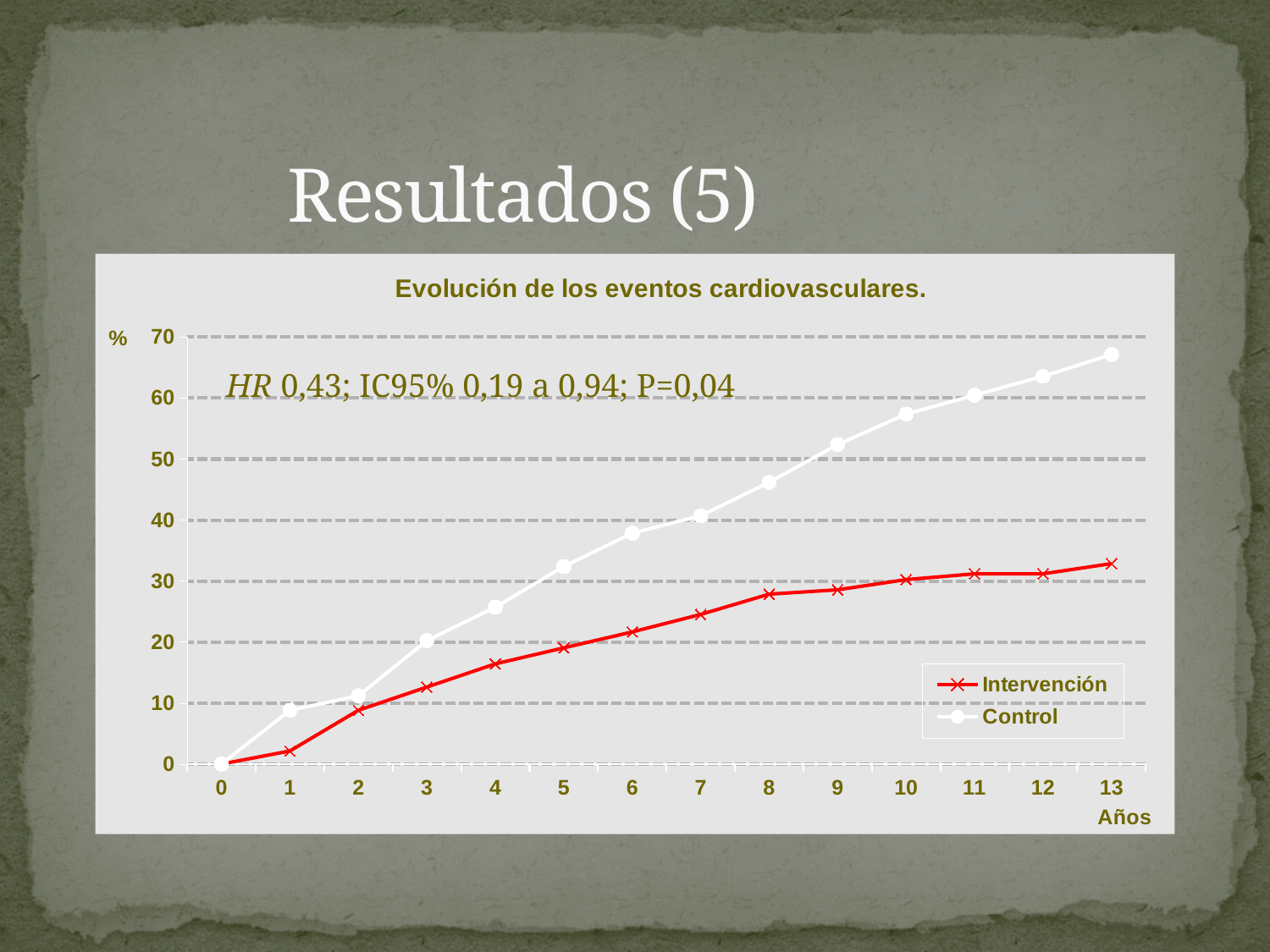
How many points (years) are plotted along the x axis for each series? 14 Is the value for Control at year 13 greater or less than 60? greater At year 13, which series has the higher value, Intervención or Control? Control Is the value for Intervención at year 13 greater or less than 40? less Is the value for Intervención at year 8 greater or less than 30? less What kind of chart is shown on the slide? line chart What is the title of the chart? Evolución de los eventos cardiovasculares. How many series does the legend list? 2 Do the values for the Control series rise or fall as the years increase? rise What is the label of the x axis? Años